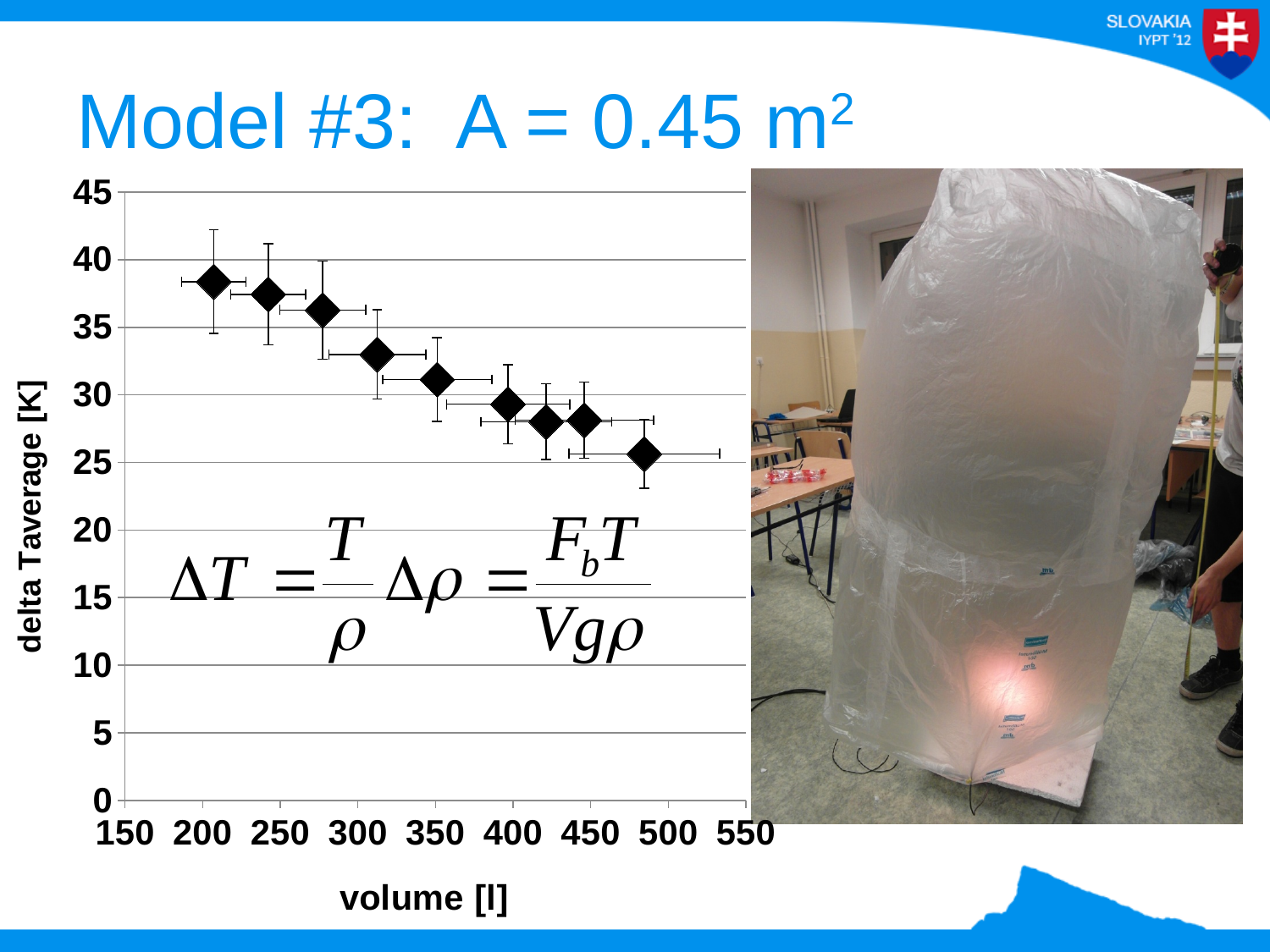
What kind of chart is shown on the slide? scatter plot Is the delta T value for the data point near 445 l greater or less than 30 K? less Is the delta T value for the leftmost data point (smallest volume) greater or less than 35 K? greater What is the label of the y axis of the chart? delta Taverage [K] Does the lowest delta T value occur at the smallest or the largest volume? largest volume Does the highest delta T value occur at the smallest or the largest volume? smallest volume How many data points are plotted on the chart? 9 Do the delta T values rise or fall as volume increases along the x axis? fall Is the delta T value for the rightmost data point (largest volume) greater or less than 30 K? less What is the label of the x axis of the chart? volume [l]